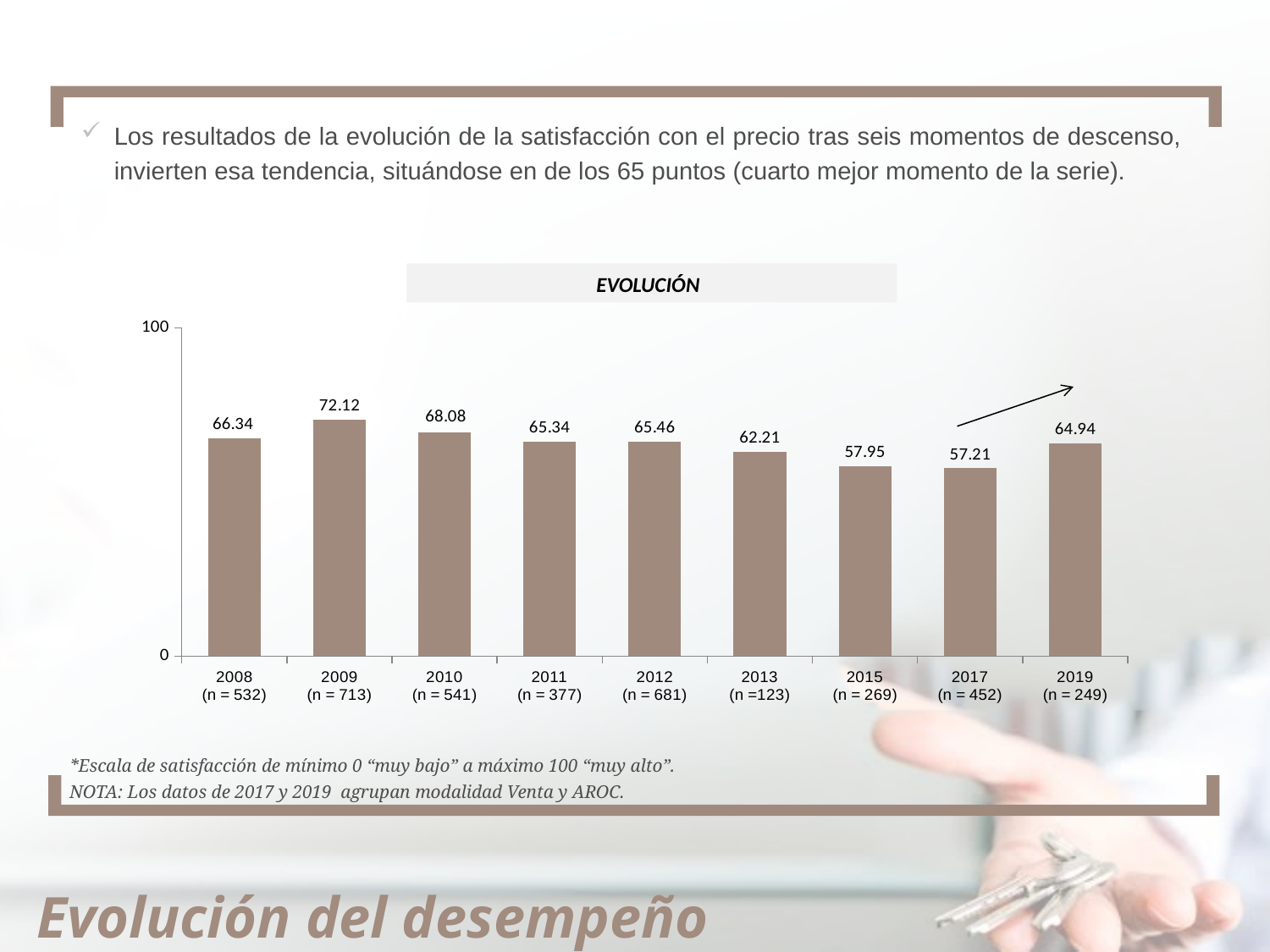
Which year has the highest value? 2009 Which is larger, the value for 2008 or the value for 2010? 2010 Do the values rise or fall from 2010 to 2017? fall What is the difference between the values for 2019 and 2017? 7.73 What kind of chart is shown? bar chart What is the title of the chart? EVOLUCIÓN What is the value for 2019? 64.94 What is the value for 2017? 57.21 What is the value for 2009? 72.12 How many years are shown on the x axis? 9 What is the difference between the values for 2009 and 2017? 14.91 Which year has the lowest value? 2017